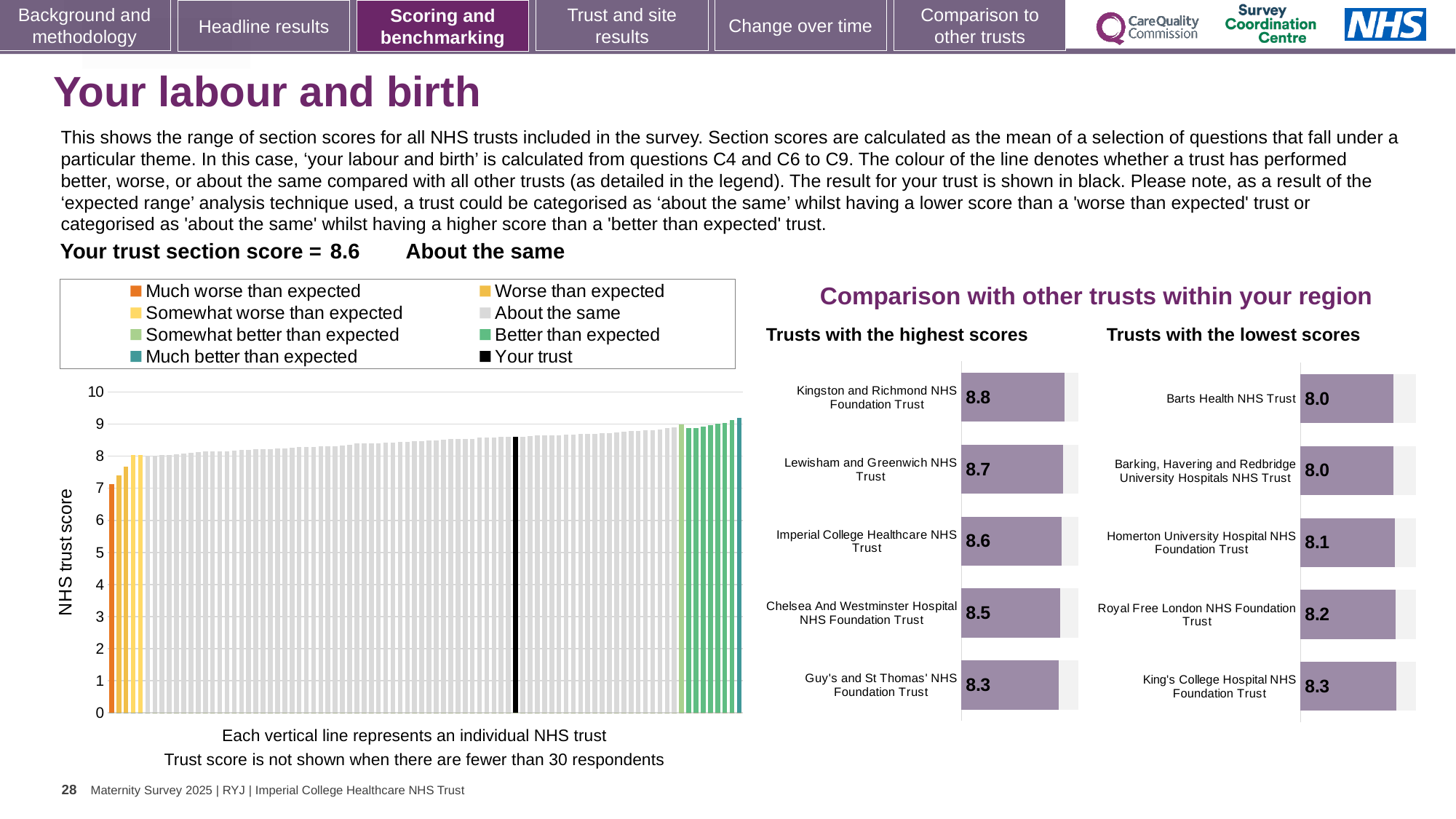
In the 'Trusts with the highest scores' chart, which has the larger score: Lewisham and Greenwich NHS Trust or Chelsea And Westminster Hospital NHS Foundation Trust? Lewisham and Greenwich NHS Trust In the large 'NHS trust score' chart, do the bar values rise or fall from left to right? Rise What kind of chart is the large 'NHS trust score' chart on the left? Bar chart In the 'Trusts with the highest scores' chart, what is the difference between the scores of Kingston and Richmond NHS Foundation Trust and Guy's and St Thomas' NHS Foundation Trust? 0.5 How many entries does the legend of the large 'NHS trust score' chart list? 8 In the 'Trusts with the lowest scores' chart, what is the score for Homerton University Hospital NHS Foundation Trust? 8.1 In the 'Trusts with the highest scores' chart, which trust has the highest score? Kingston and Richmond NHS Foundation Trust In the 'Trusts with the lowest scores' chart, what is the difference between the scores of King's College Hospital NHS Foundation Trust and Barts Health NHS Trust? 0.3 In the large 'NHS trust score' chart, is the value of the tallest bar greater or less than 9? greater In the 'Trusts with the lowest scores' chart, which trust has the highest score? King's College Hospital NHS Foundation Trust How many trusts are listed in the 'Trusts with the lowest scores' chart? 5 In the 'Trusts with the highest scores' chart, what is the score for Kingston and Richmond NHS Foundation Trust? 8.8